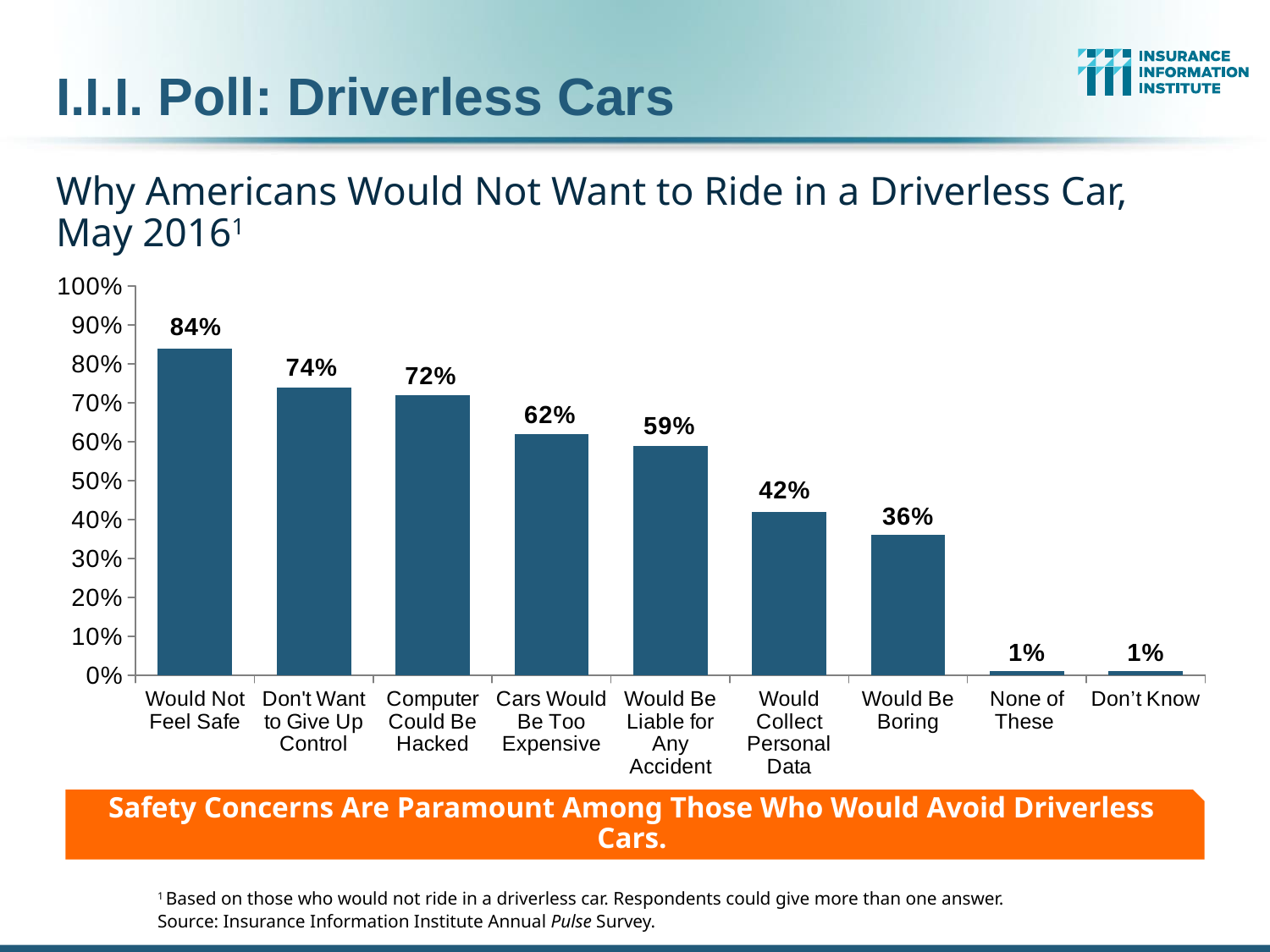
Do the values rise or fall from left to right along the x axis? Fall What percentage said cars would be too expensive? 62% What is the value for "Would Collect Personal Data"? 42% Which reason has the highest percentage? Would Not Feel Safe What is the difference between "Would Be Liable for Any Accident" and "Would Be Boring"? 23% What is the difference between "Would Not Feel Safe" and "Don't Want to Give Up Control"? 10% What percentage of respondents said they would not feel safe? 84% Which category has the lowest value, excluding the two tied at 1%? Would Be Boring Which is larger: "Computer Could Be Hacked" or "Cars Would Be Too Expensive"? Computer Could Be Hacked How many categories are shown on the x axis? 9 What kind of chart is shown on the slide? Bar chart Is the value for "Would Be Boring" greater or less than 40%? less